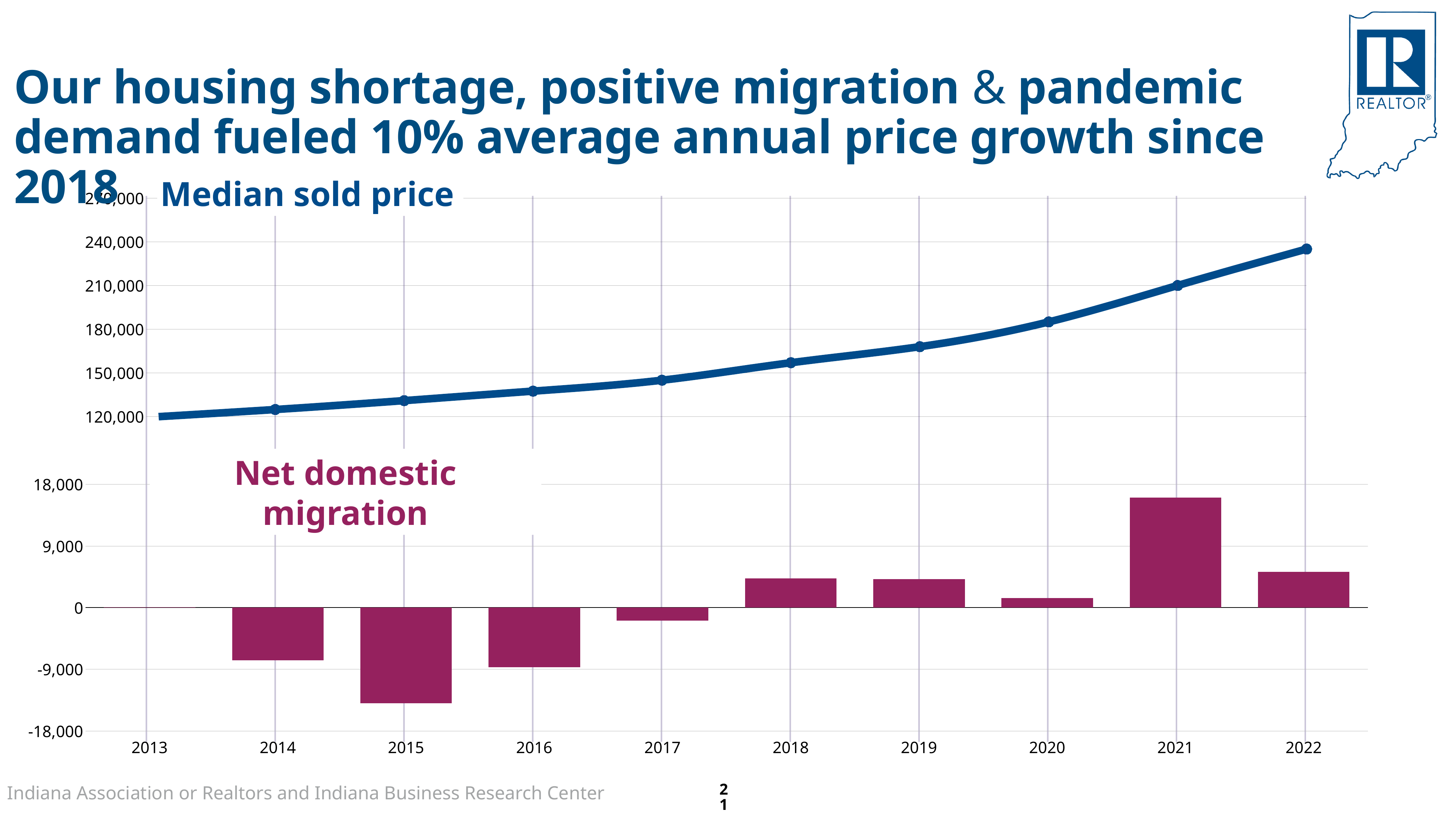
In the Median sold price chart, is the value for 2016 greater or less than 150,000? less In the Net domestic migration chart, is the value for 2015 greater or less than -9,000? less In the Median sold price chart, which year has the lowest median sold price? 2013 In the Net domestic migration chart, which year has the lowest net domestic migration? 2015 In the Median sold price chart, how many years are plotted along the x axis? 10 What kind of chart is the Median sold price chart? line chart What kind of chart is the Net domestic migration chart? bar chart In the Median sold price chart, which year has the highest median sold price? 2022 In the Net domestic migration chart, which year has the highest net domestic migration? 2021 In the Net domestic migration chart, is the value for 2021 greater or less than 9,000? greater In the Median sold price chart, do values rise or fall from 2013 to 2022? rise